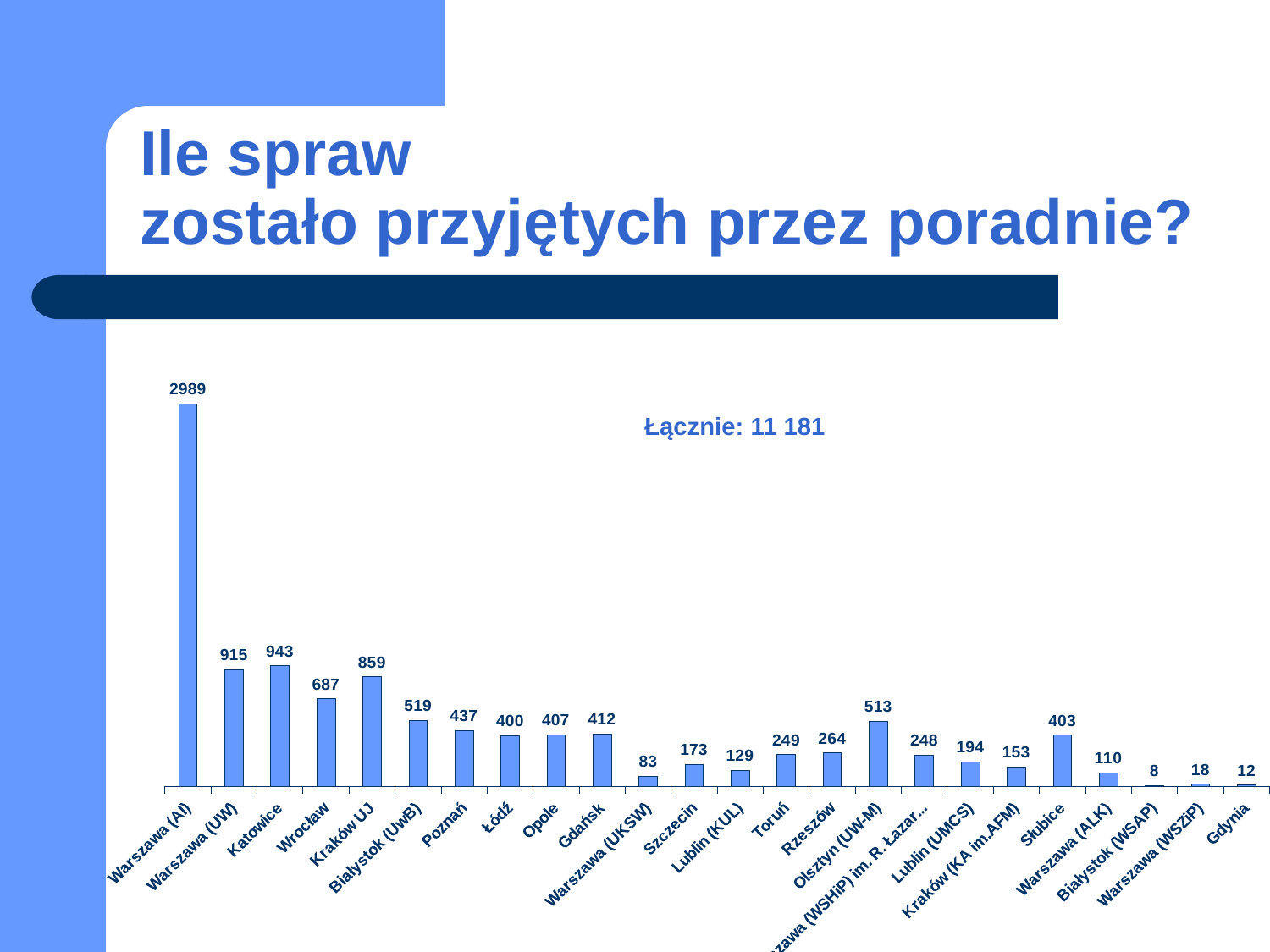
What value is shown for Olsztyn (UW-M)? 513 What value is shown for Słubice? 403 What value is shown for Katowice? 943 What is the difference between the values for Kraków UJ and Wrocław? 172 How many categories are shown on the chart? 24 What total is stated in the text annotation on the chart (Łącznie)? 11 181 What is the difference between the values for Warszawa (AI) and Katowice? 2046 Which category has the lowest value? Białystok (WSAP) Which is larger, the value for Szczecin or the value for Lublin (KUL)? Szczecin Which category has the highest value? Warszawa (AI) What kind of chart is shown on the slide? bar chart Which is larger, the value for Toruń or the value for Rzeszów? Rzeszów